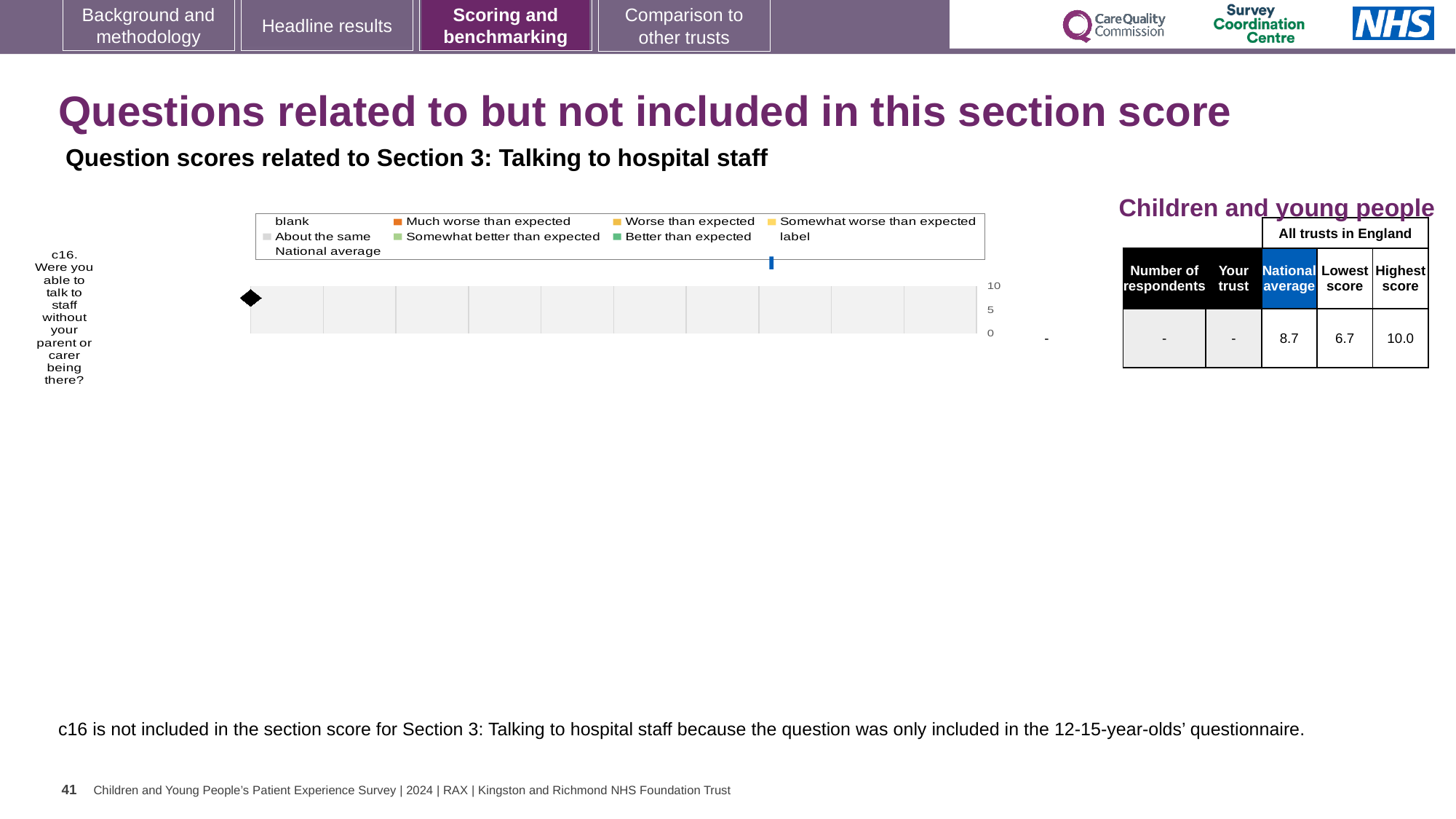
Which question is shown on the chart's category axis? c16. Were you able to talk to staff without your parent or carer being there? How many question categories are plotted on the chart? 1 In the table next to the chart, what is the lowest score across all trusts in England for c16? 6.7 In the table next to the chart, what is the highest score across all trusts in England for c16? 10.0 In the table next to the chart, what is the difference between the highest score and the lowest score for c16? 3.3 In the table next to the chart, what value is shown for 'Your trust' for c16? - In the table next to the chart, what is the national average score for c16? 8.7 In the table next to the chart, is the national average for c16 greater or less than 5? greater What is the maximum value shown on the chart's score axis? 10 What kind of chart is shown on the slide? bar chart